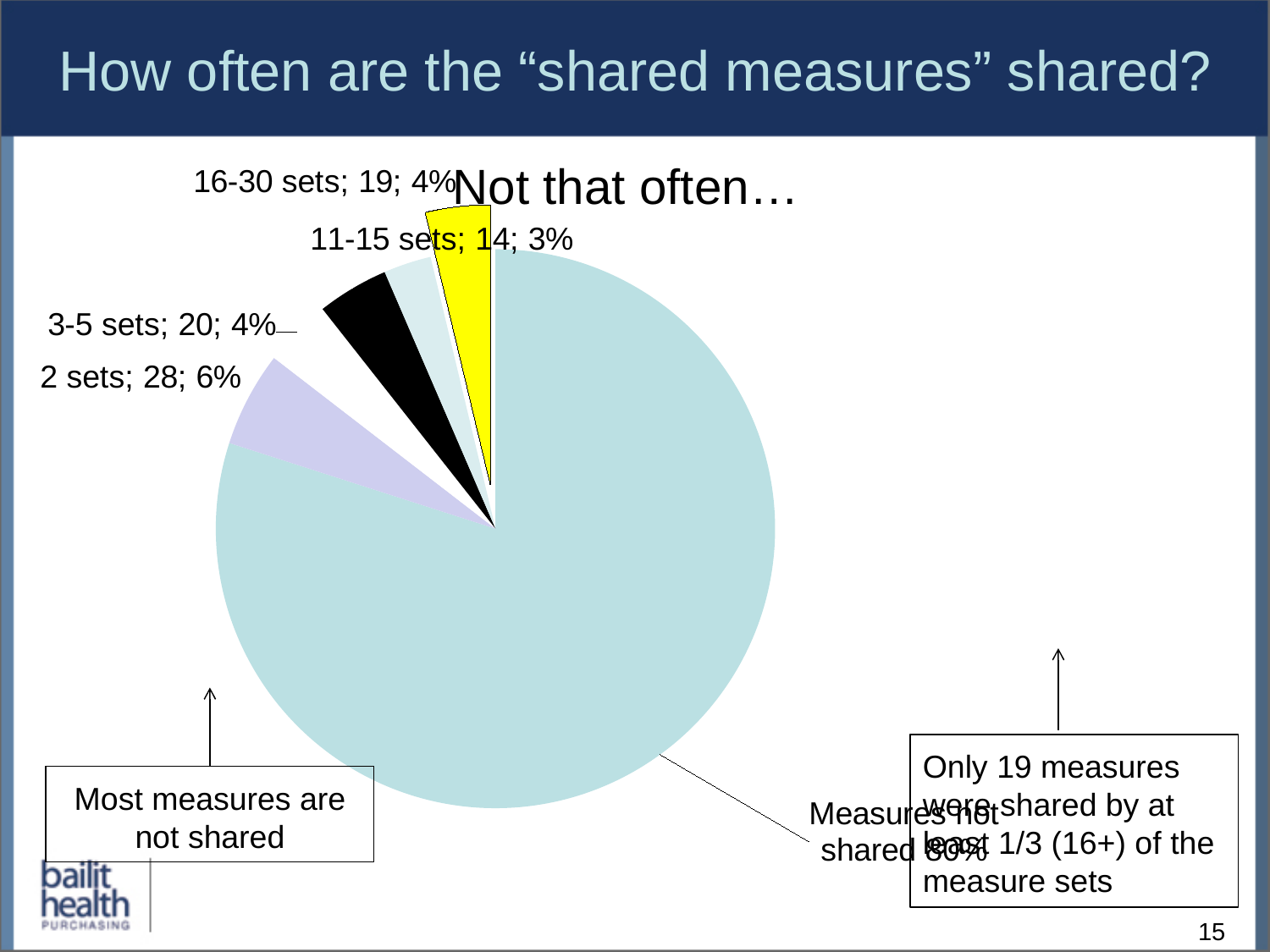
How many more measures are in the "2 sets" slice than in the "3-5 sets" slice? 8 How many measures are in the "3-5 sets" slice? 20 Which labeled slice has the smallest number of measures? 11-15 sets What share of the pie does the "11-15 sets" slice represent? 3% How many measures are in the "16-30 sets" slice? 19 What share of the pie does the "2 sets" slice represent? 6% Which slice has more measures, "2 sets" or "3-5 sets"? 2 sets What share of the pie does the "Measures not shared" slice represent? 80% Which slice is the largest in the pie chart? Measures not shared How many measures are in the "2 sets" slice? 28 What kind of chart is shown on the slide? Pie chart What is the title of the chart? Not that often…